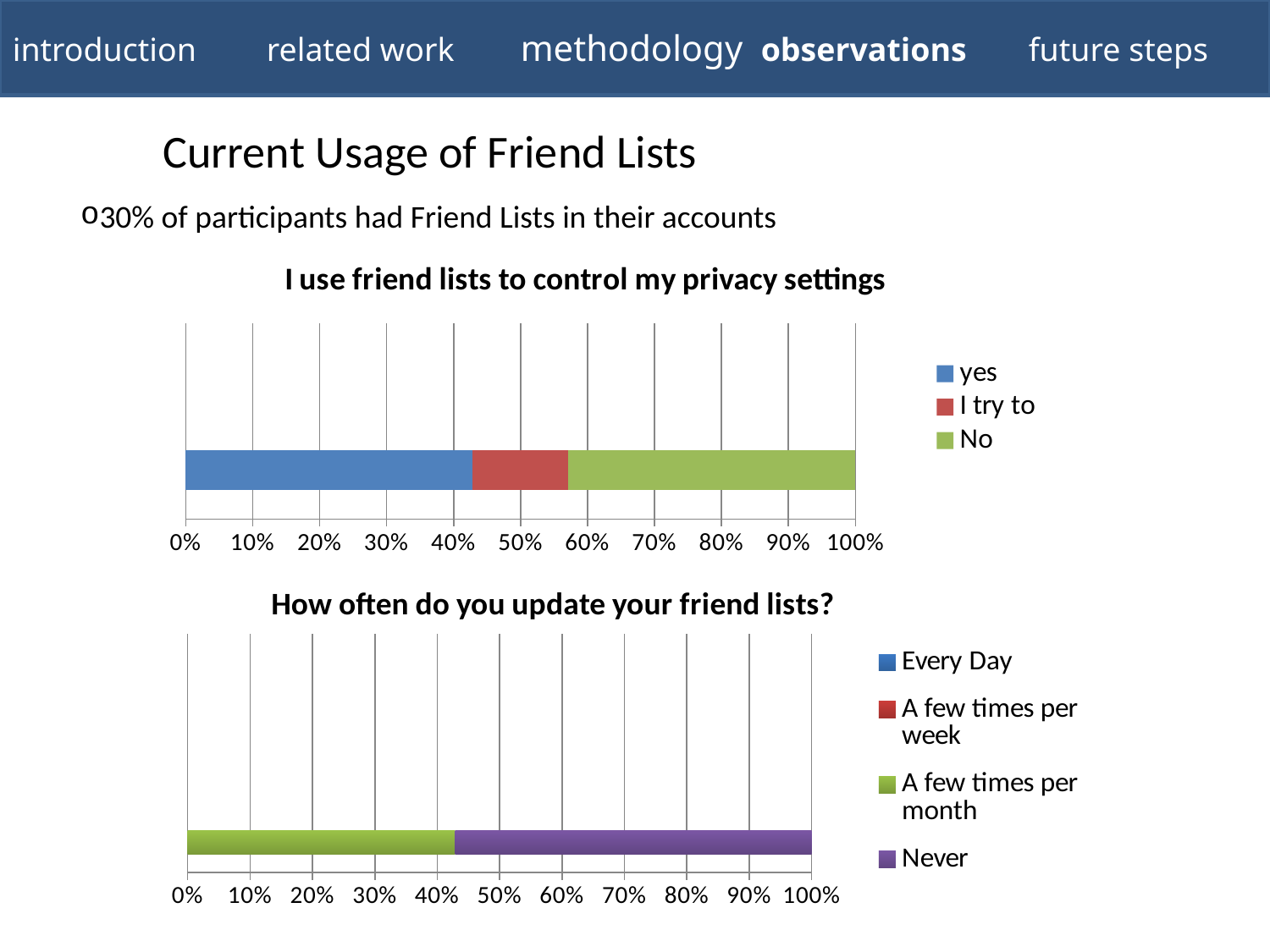
In the "How often do you update your friend lists?" chart, is the value for "A few times per month" greater or less than 50%? less What kind of chart is "I use friend lists to control my privacy settings"? bar chart In the "How often do you update your friend lists?" chart, is the value for "Never" greater or less than 50%? greater What is the title of the lower chart on the slide? How often do you update your friend lists? In the "I use friend lists to control my privacy settings" chart, is the segment for "No" larger or smaller than the segment for "I try to"? larger In the "How often do you update your friend lists?" chart, is the segment for "Never" larger or smaller than the segment for "A few times per month"? larger In the "How often do you update your friend lists?" chart, what colour represents "Never"? purple In the "I use friend lists to control my privacy settings" chart, is the value for "I try to" greater or less than 20%? less How many series does the legend of the "How often do you update your friend lists?" chart list? 4 In the "I use friend lists to control my privacy settings" chart, which series has the smallest segment? I try to How many series does the legend of the "I use friend lists to control my privacy settings" chart list? 3